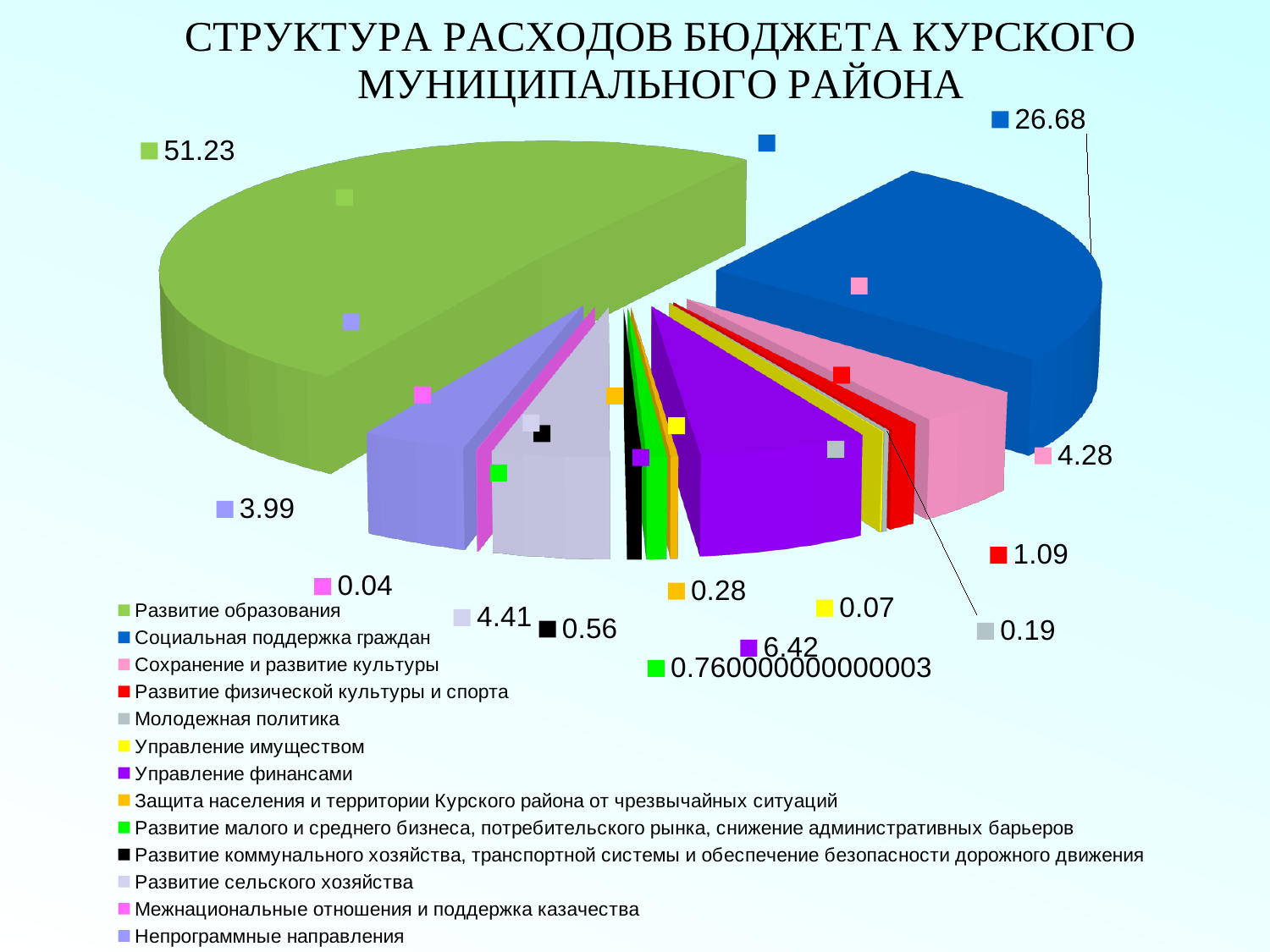
What kind of chart is shown on the slide? pie chart What is the value for Сохранение и развитие культуры? 4.28 Which is larger, the value for Развитие сельского хозяйства or the value for Сохранение и развитие культуры? Развитие сельского хозяйства What is the value for Развитие образования? 51.23 What is the title of the chart? СТРУКТУРА РАСХОДОВ БЮДЖЕТА КУРСКОГО МУНИЦИПАЛЬНОГО РАЙОНА Which category has the smallest value? Межнациональные отношения и поддержка казачества What is the value for Непрограммные направления? 3.99 What is the value for Управление финансами? 6.42 How many categories does the legend list? 13 What is the value for Социальная поддержка граждан? 26.68 What is the difference between the values for Развитие образования and Социальная поддержка граждан? 24.55 Which category has the largest slice of the pie? Развитие образования